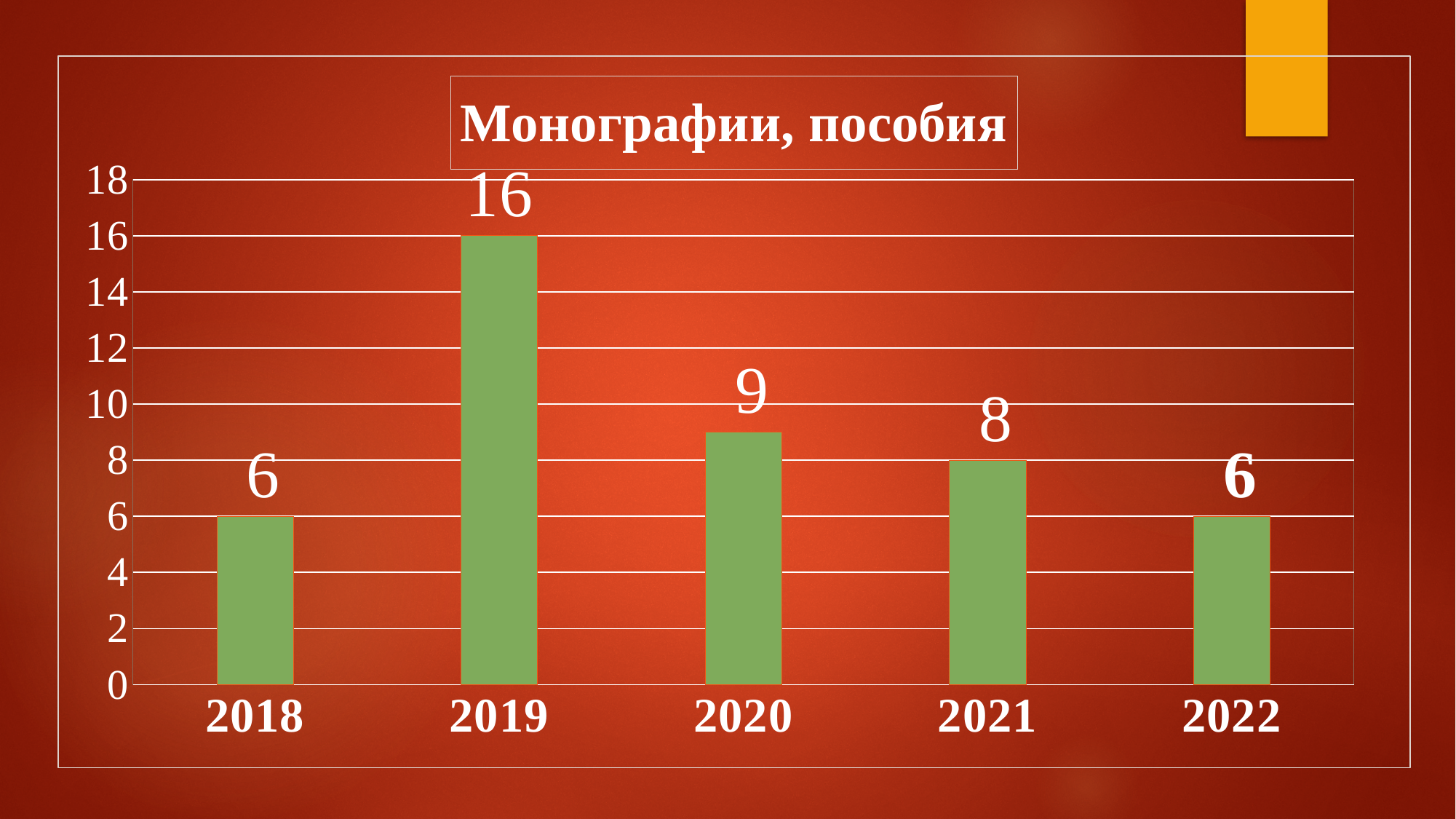
What is the difference between the values for 2019 and 2020? 7 What kind of chart is this? bar chart What is the title of the chart? Монографии, пособия Which is larger, the value for 2020 or the value for 2021? 2020 What is the difference between the values for 2021 and 2022? 2 What is the value for 2020? 9 What is the value for 2021? 8 Is the value for 2019 greater or less than 14? greater What is the value for 2018? 6 How many years are shown on the x axis? 5 Which year has the highest value? 2019 What is the value for 2019? 16